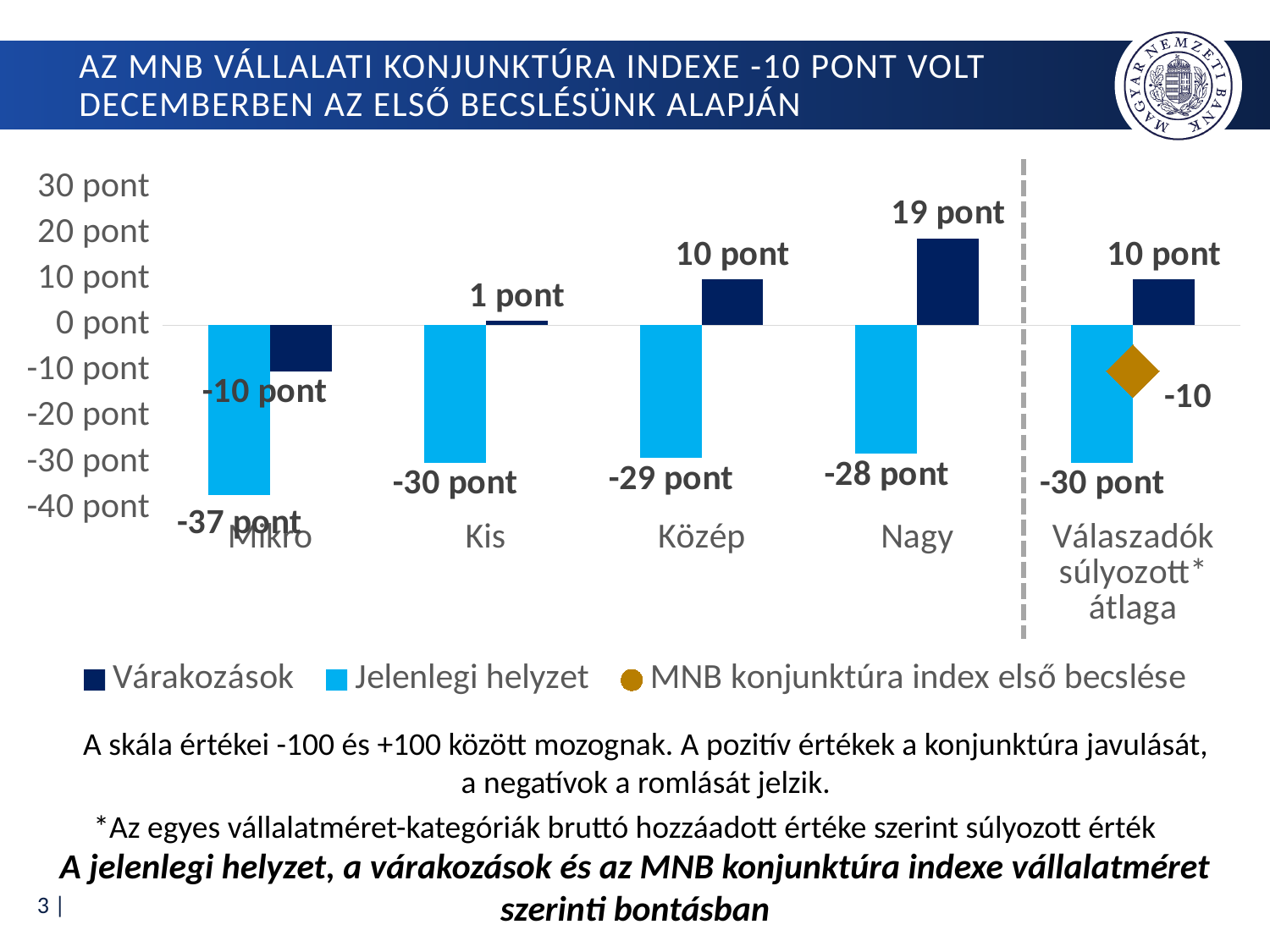
Which is larger, the Jelenlegi helyzet value for Kis or for Nagy? Nagy What is the difference between the Várakozások values for Nagy and Közép? 9 pont What is the Várakozások value for Kis? 1 pont What is the Várakozások value for Nagy? 19 pont Which category has the lowest Jelenlegi helyzet value? Mikro What kind of chart is shown on the slide? Bar chart Do the Várakozások values rise or fall from Mikro to Nagy? Rise What is the Jelenlegi helyzet value for Mikro? -37 pont How many series does the legend list? 3 Which category has the highest Várakozások value? Nagy What is the value of the MNB konjunktúra index első becslése marker? -10 How many categories are shown on the x axis? 5